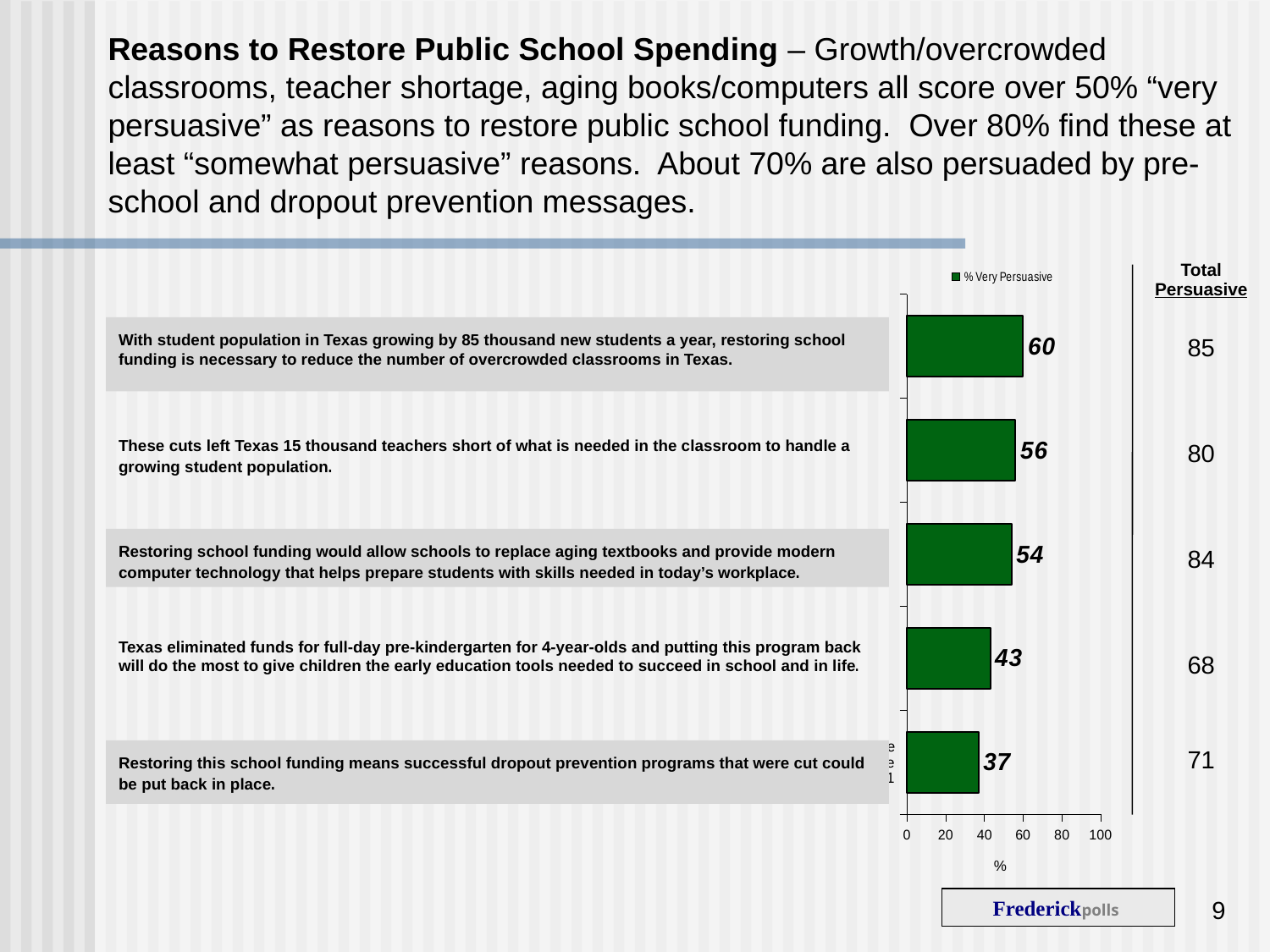
What is the difference in % Very Persuasive between the overcrowded classrooms statement and the dropout prevention statement? 23 What is the % Very Persuasive value for the statement about full-day pre-kindergarten for 4-year-olds? 43 What is the % Very Persuasive value for the statement about overcrowded classrooms (student population growing by 85 thousand a year)? 60 Which statement has the highest % Very Persuasive value? Overcrowded classrooms (student population growing by 85 thousand new students a year) What type of chart is used on this slide? Bar chart What is the % Very Persuasive value for the statement about Texas being 15 thousand teachers short? 56 What is the % Very Persuasive value for the statement about replacing aging textbooks and providing modern computer technology? 54 What is the % Very Persuasive value for the statement about dropout prevention programs? 37 Which statement has the lowest % Very Persuasive value? Dropout prevention programs How many statements (bars) are shown in the chart? 5 What series does the chart legend list? % Very Persuasive Which has a higher % Very Persuasive value: the teacher shortage statement or the pre-kindergarten statement? Teacher shortage statement